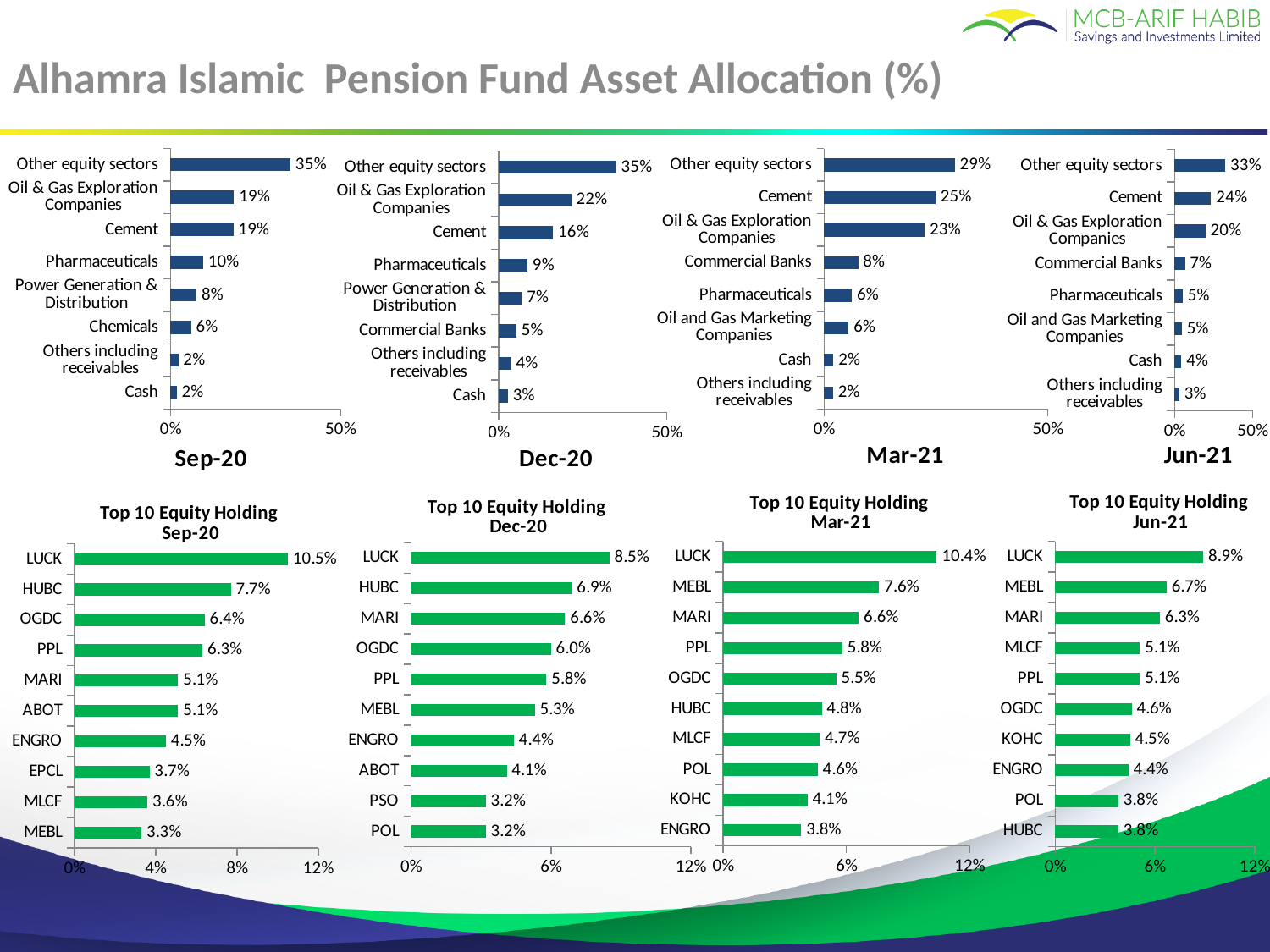
How many categories are shown in the Mar-21 asset allocation chart? 8 In the Mar-21 asset allocation chart, which category has the highest value? Other equity sectors In the Top 10 Equity Holding Sep-20 chart, what is the value for HUBC? 7.7% What kind of chart is the Top 10 Equity Holding Jun-21 chart? Bar chart In the Top 10 Equity Holding Jun-21 chart, which is larger, MEBL or MARI? MEBL In the Jun-21 asset allocation chart, what is the difference between the values for Cement and Oil & Gas Exploration Companies? 4 percentage points In the Dec-20 asset allocation chart, what is the value for Oil & Gas Exploration Companies? 22% In the Sep-20 asset allocation chart, what is the value for Pharmaceuticals? 10% In the Top 10 Equity Holding Mar-21 chart, which holding has the lowest value? ENGRO In the Top 10 Equity Holding Dec-20 chart, what is the difference between LUCK and HUBC? 1.6 percentage points In the Mar-21 asset allocation chart, what is the value for Commercial Banks? 8% In the Top 10 Equity Holding Dec-20 chart, which holding has the highest value? LUCK